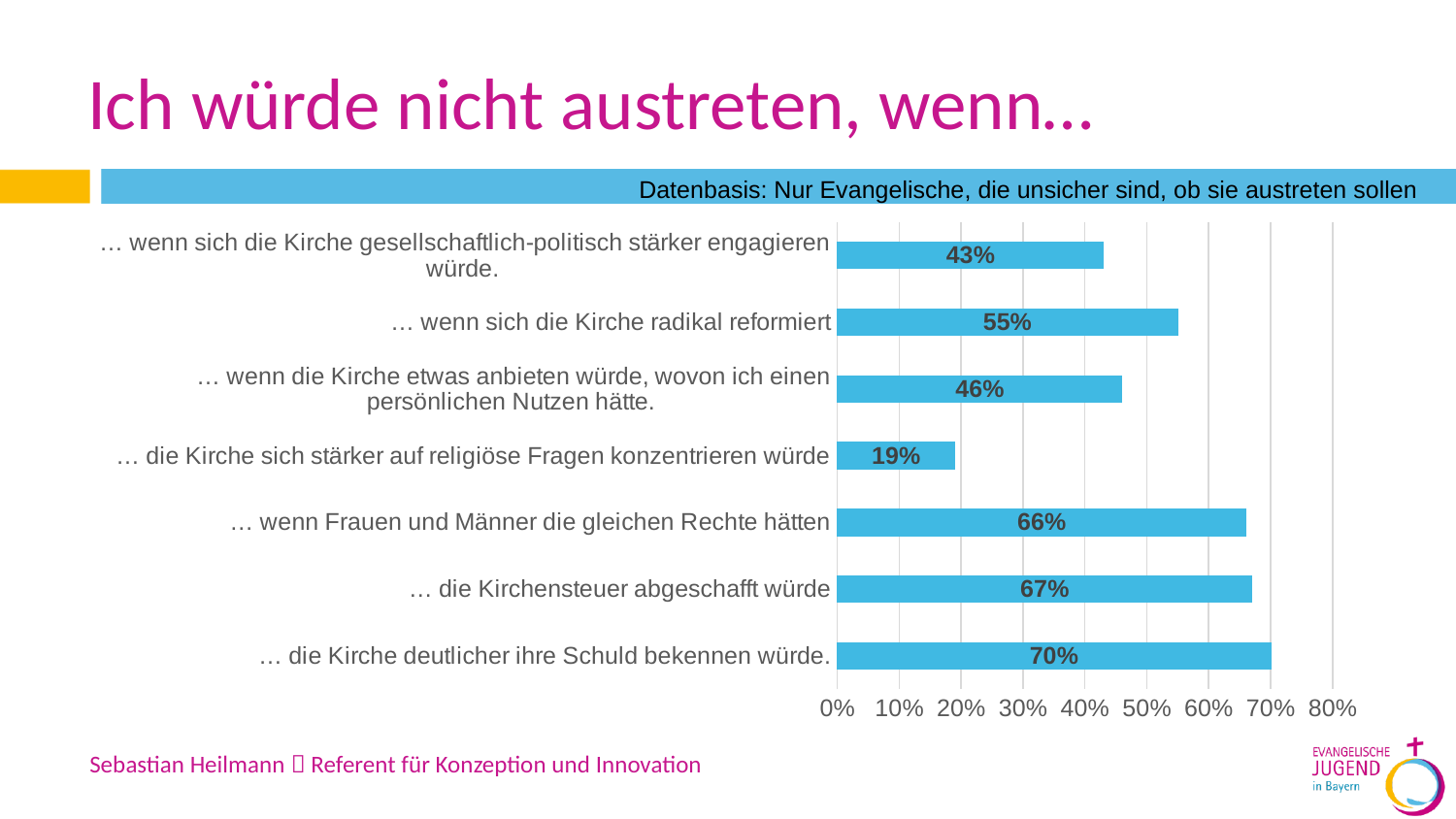
What is the value for "… die Kirche sich stärker auf religiöse Fragen konzentrieren würde"? 19% What is the value for "… wenn sich die Kirche radikal reformiert"? 55% What is the value for "… die Kirchensteuer abgeschafft würde"? 67% How many categories are shown in the chart? 7 Which category has the lowest value? … die Kirche sich stärker auf religiöse Fragen konzentrieren würde What is the highest value shown on the x axis? 80% What is the difference between the values for "… wenn Frauen und Männer die gleichen Rechte hätten" and "… wenn sich die Kirche gesellschaftlich-politisch stärker engagieren würde."? 23% What is the difference between the values for "… die Kirche deutlicher ihre Schuld bekennen würde." and "… die Kirche sich stärker auf religiöse Fragen konzentrieren würde"? 51% Which category has the highest value? … die Kirche deutlicher ihre Schuld bekennen würde. Which is larger: the value for "… wenn sich die Kirche radikal reformiert" or the value for "… wenn die Kirche etwas anbieten würde, wovon ich einen persönlichen Nutzen hätte."? … wenn sich die Kirche radikal reformiert What kind of chart is shown on the slide? bar chart Is the value for "… wenn sich die Kirche gesellschaftlich-politisch stärker engagieren würde." greater or less than 50%? less